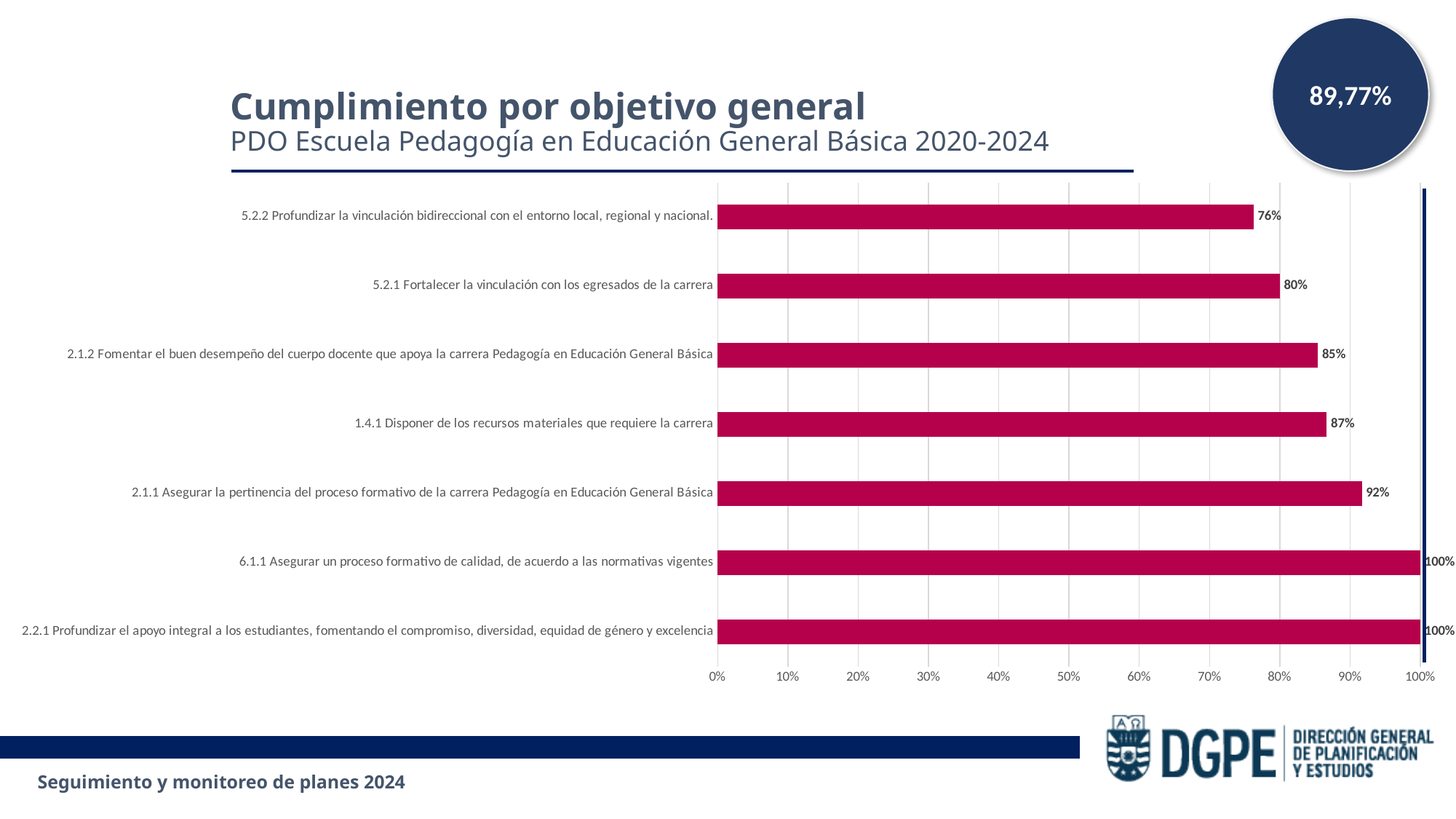
What is the value for objective 2.1.2 Fomentar el buen desempeño del cuerpo docente que apoya la carrera Pedagogía en Educación General Básica? 85% How many objectives are shown in the chart? 7 Which is larger, the value for objective 1.4.1 or the value for objective 5.2.1? 1.4.1 Disponer de los recursos materiales que requiere la carrera What is the value for objective 1.4.1 Disponer de los recursos materiales que requiere la carrera? 87% What is the difference between the values for objective 2.1.1 and objective 5.2.1? 12% What overall percentage is shown in the circle at the top right of the slide? 89,77% How many objectives reach 100%? 2 Which objective has the lowest value in the chart? 5.2.2 Profundizar la vinculación bidireccional con el entorno local, regional y nacional. What kind of chart is shown on the slide? bar chart What is the value for objective 2.1.1 Asegurar la pertinencia del proceso formativo de la carrera Pedagogía en Educación General Básica? 92% What is the value for objective 5.2.2 Profundizar la vinculación bidireccional con el entorno local, regional y nacional? 76% Is the value for objective 5.2.2 greater or less than 80%? less